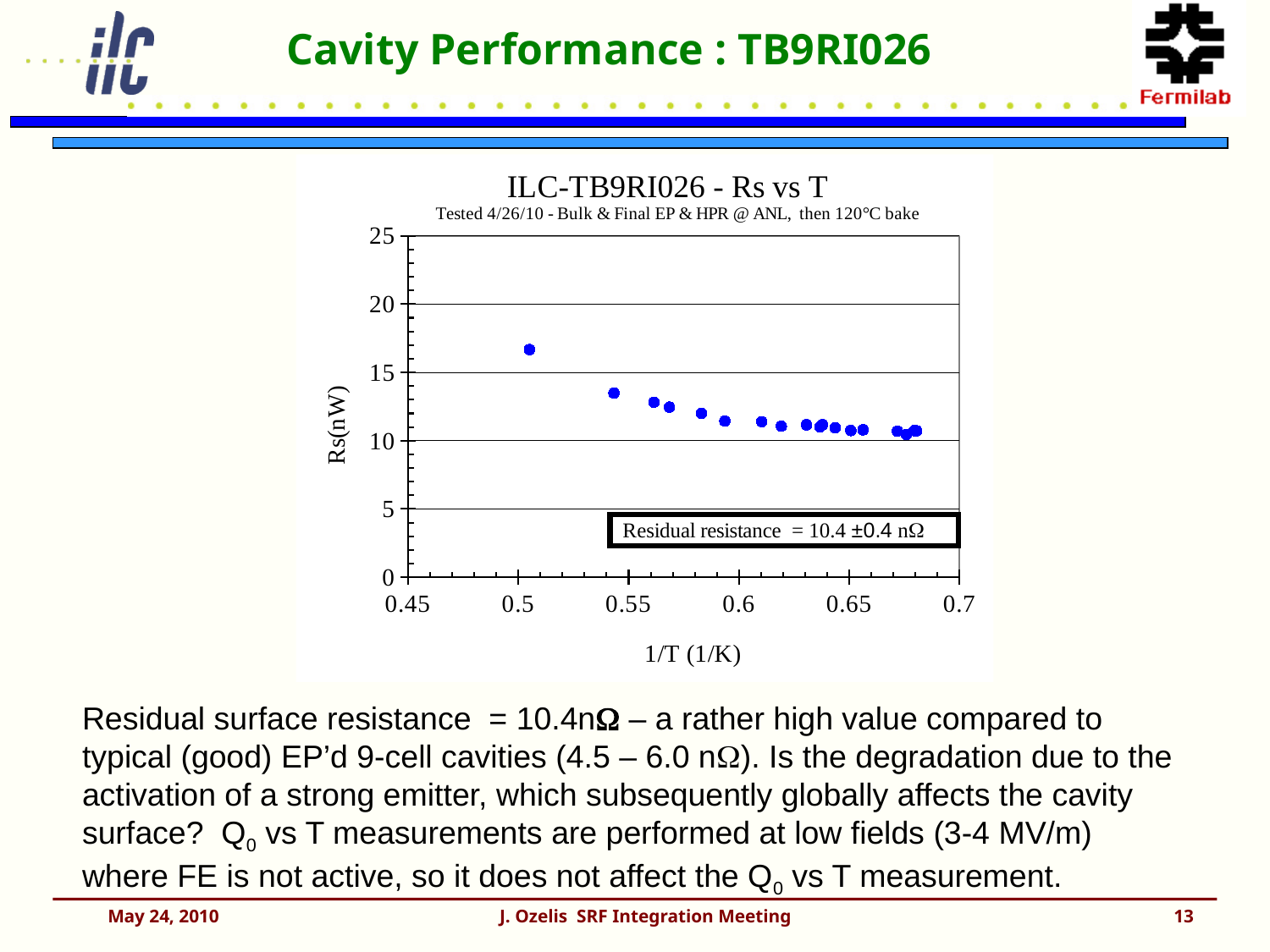
What is the label of the x axis of the chart? 1/T (1/K) What is the residual resistance value stated in the box on the chart? 10.4 ±0.4 nΩ Is the Rs value of the data point near 1/T = 0.55 greater or less than 15? less Is the Rs value of the leftmost data point (near 1/T = 0.5) greater or less than 20? less As 1/T increases along the x axis, do the Rs values rise or fall? Fall What kind of chart is shown on the slide? Scatter chart Is the Rs value of the data point near 1/T = 0.6 greater or less than 10? greater What is the title of the chart? ILC-TB9RI026 - Rs vs T Which data point has the highest Rs value: the one at the lowest 1/T or the one at the highest 1/T? The one at the lowest 1/T